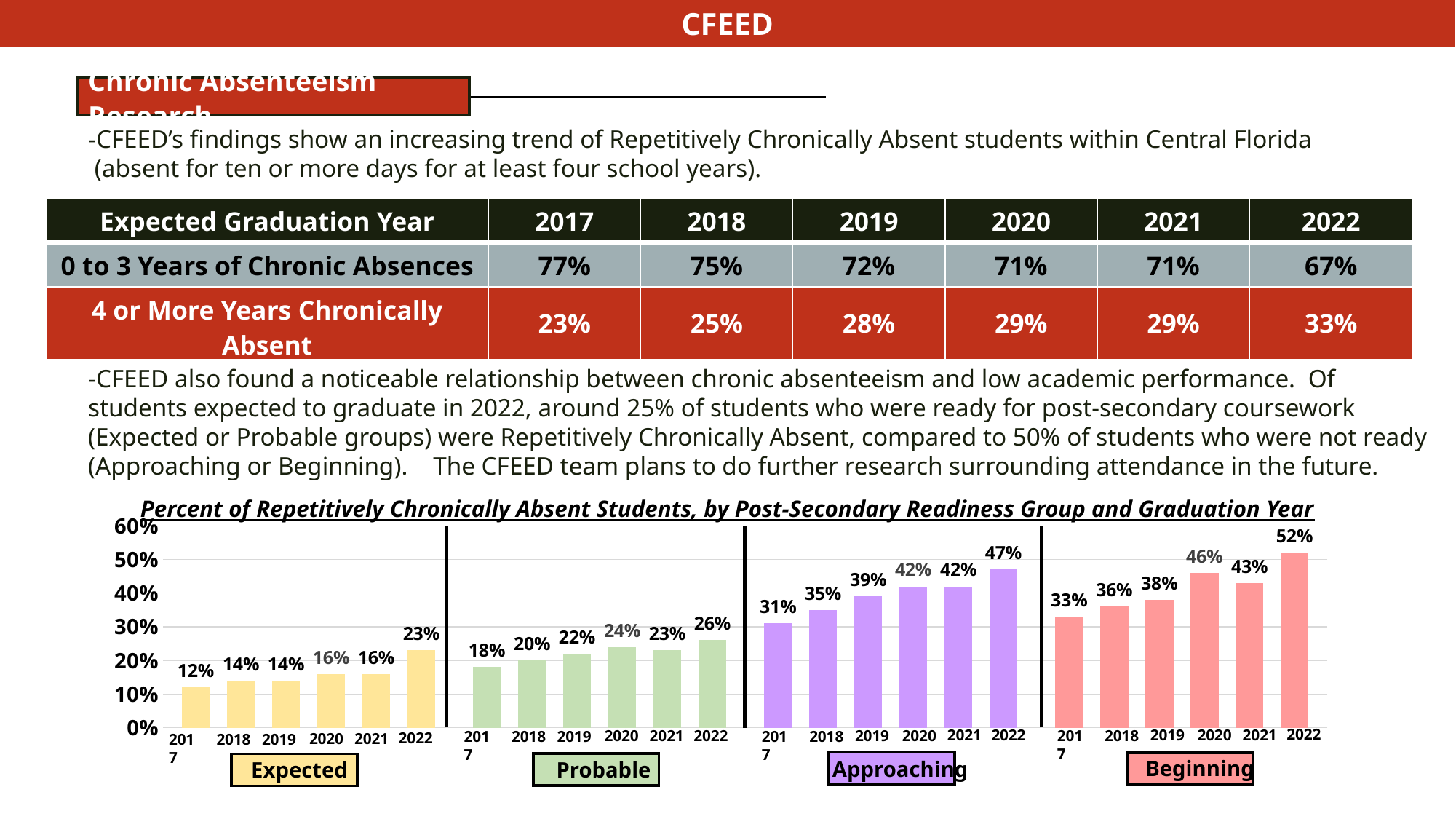
Which year has the lowest value in the Expected group? 2017 What colour are the bars for the Probable group? Green What is the difference between the Beginning group's 2022 value and its 2017 value? 19% Is the value for the Approaching group in 2022 greater or less than 40%? greater What is the value for the Beginning group in 2020? 46% Which year has the highest value in the Beginning group? 2022 What is the value for the Approaching group in 2019? 39% Do the values for the Approaching group generally rise or fall from 2017 to 2022? Rise Which is larger: the Probable group's 2020 value or its 2021 value? 2020 (24%) How many readiness groups are shown in the chart? 4 What kind of chart is shown on the slide? Bar chart What is the value for the Expected group in 2022? 23%